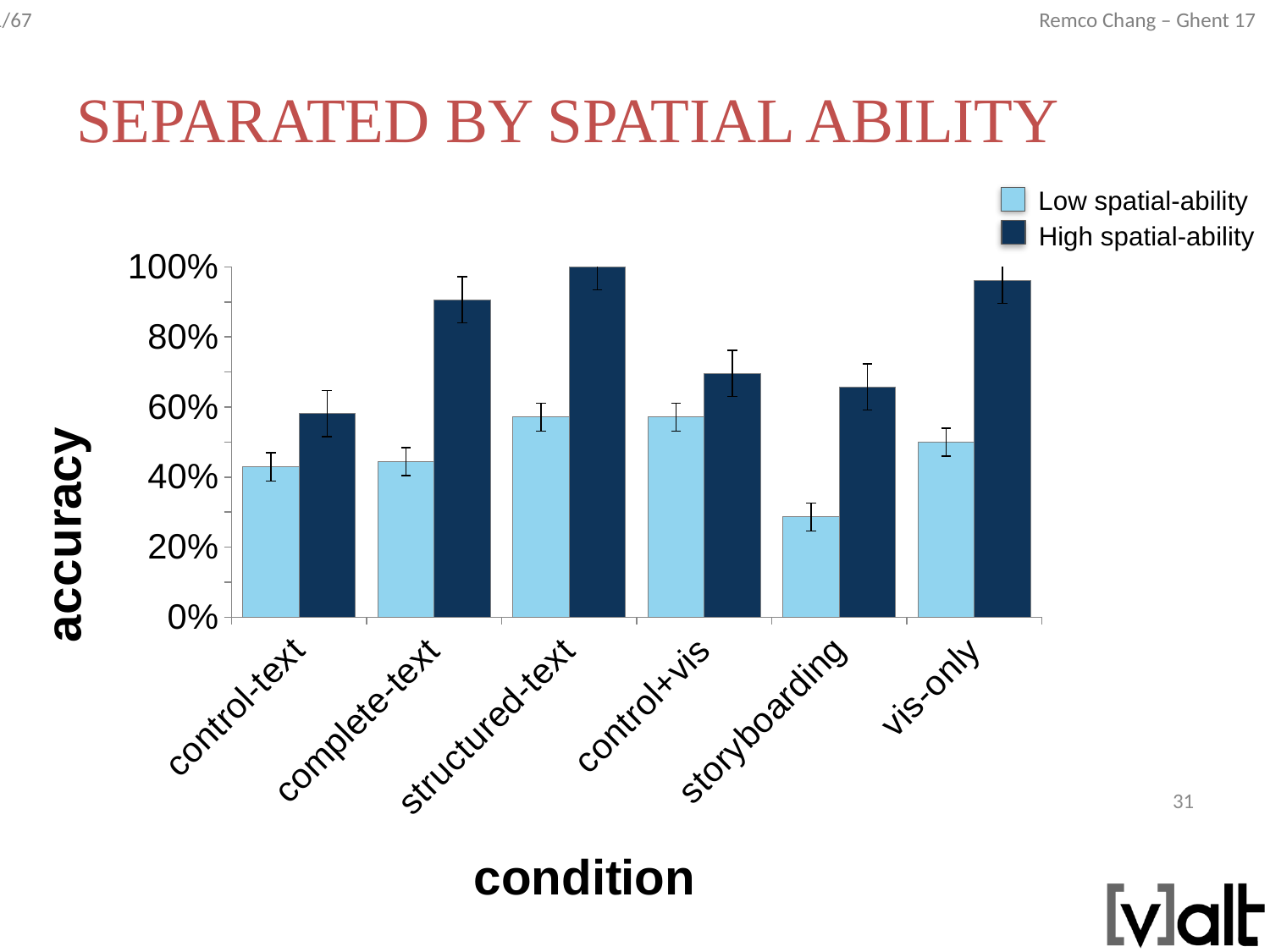
How many series does the legend list? 2 Is the High spatial-ability accuracy for complete-text greater or less than 80%? greater Which condition has the highest accuracy for the High spatial-ability series? structured-text For the vis-only condition, which series has the higher accuracy, Low spatial-ability or High spatial-ability? High spatial-ability What is the label of the y axis? accuracy What kind of chart is shown on the slide? bar chart Which condition has the lowest accuracy for the Low spatial-ability series? storyboarding Is the Low spatial-ability accuracy for storyboarding greater or less than 40%? less How many conditions are shown on the x axis? 6 Which series is shown in dark blue in the legend? High spatial-ability Which condition has the lowest accuracy for the High spatial-ability series? control-text Is the Low spatial-ability accuracy for control-text greater or less than 60%? less